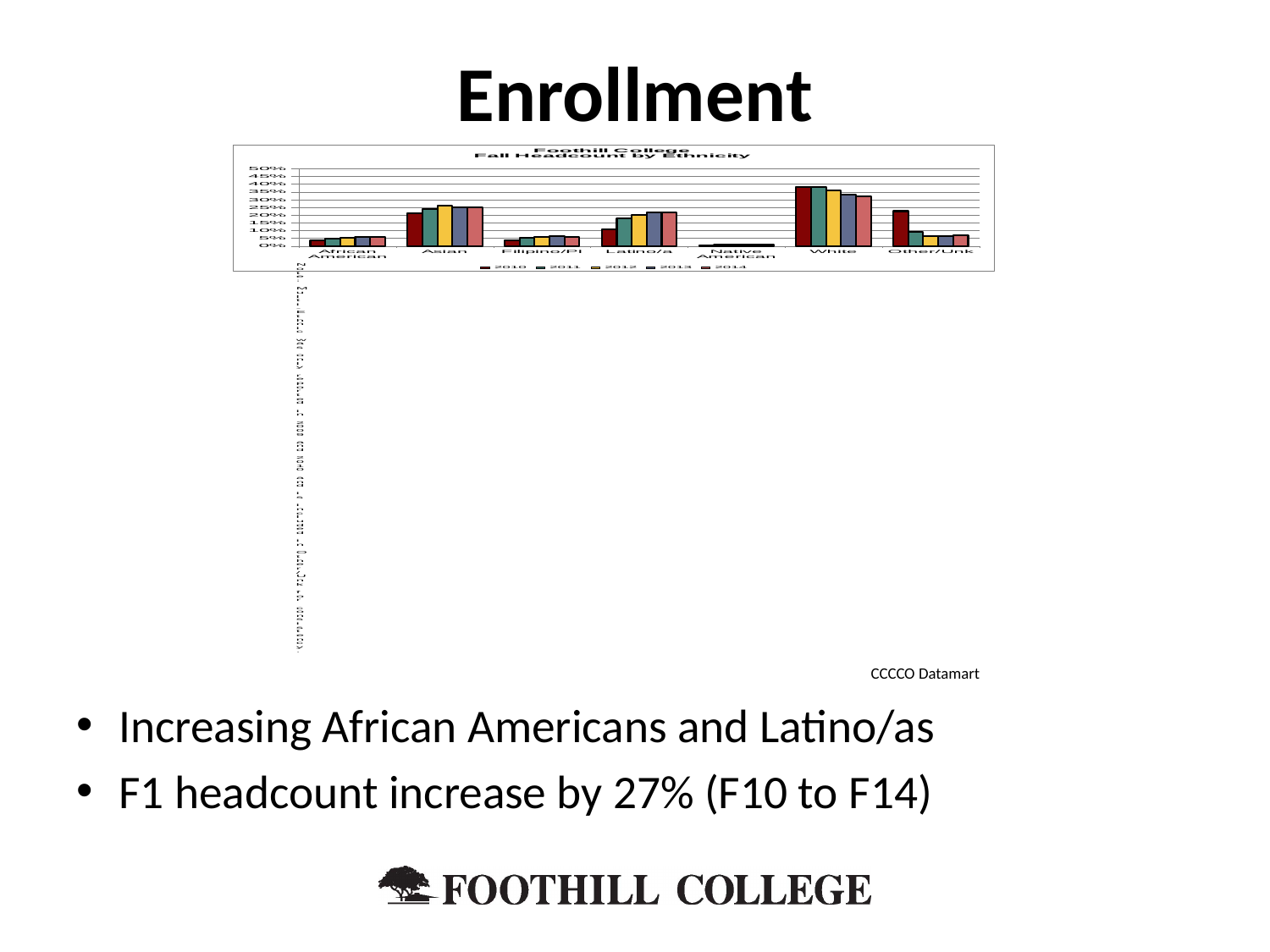
Is the 2010 value for Other/Unk greater or less than 15%? greater Is the 2010 value for White greater or less than 30%? greater In 2010, which is larger: the value for Asian or the value for Latino/a? Asian What type of chart is shown on the slide? bar chart What is the title of the chart? Foothill College Fall Headcount by Ethnicity Do the values for Latino/a rise or fall from 2010 to 2014? rise Which ethnicity category has the highest headcount share in the chart? White Do the values for White rise or fall from 2010 to 2014? fall How many series (years) does the chart legend list? 5 Which ethnicity category has the lowest headcount share in the chart? Native American Is the 2010 value for Latino/a greater or less than 15%? less How many ethnicity categories are shown on the x axis of the chart? 7